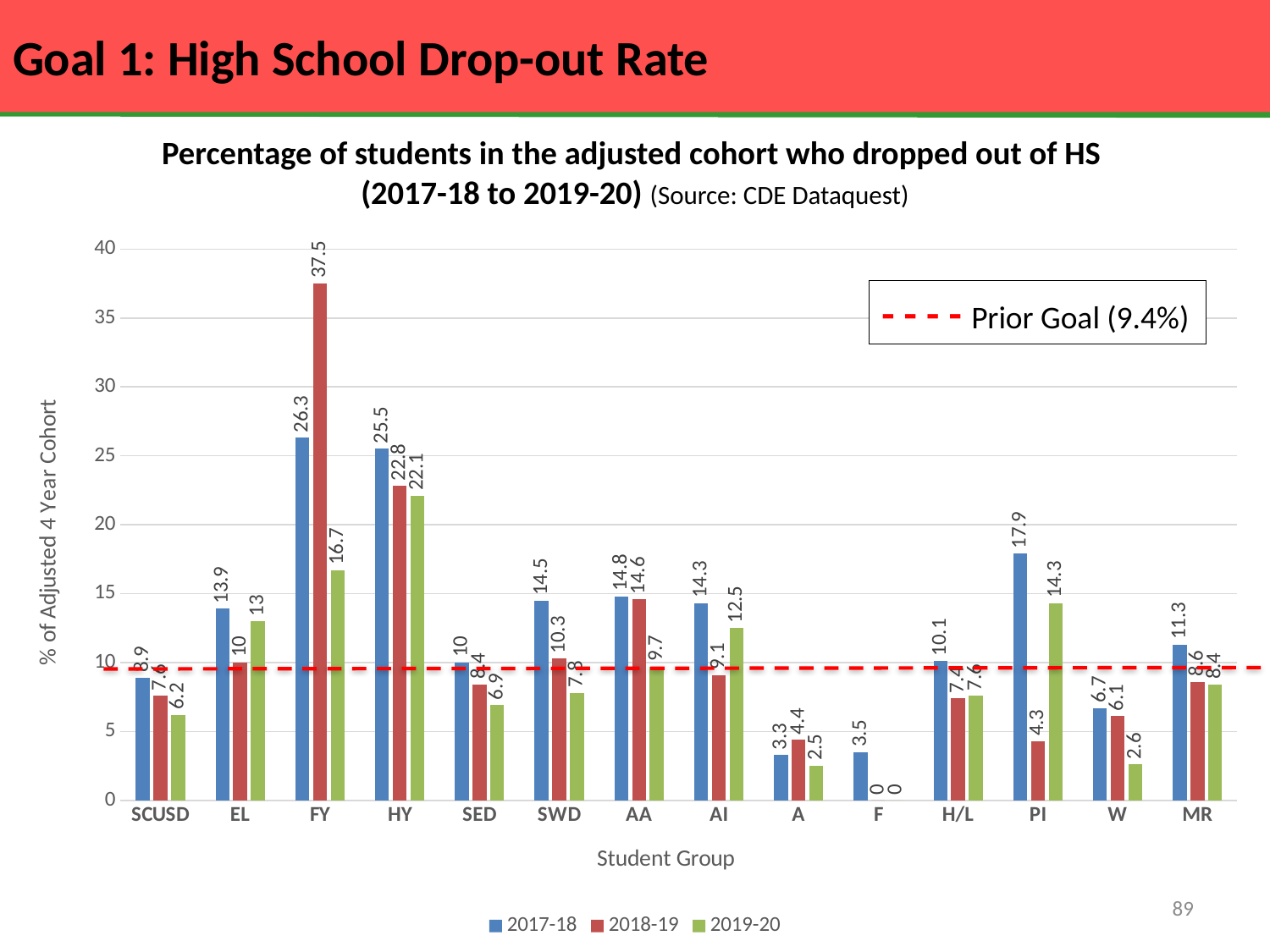
Which is larger for AI: the 2018-19 value or the 2019-20 value? 2019-20 What is the 2018-19 value for FY? 37.5 What is the difference between the 2017-18 and 2019-20 values for FY? 9.6 What is the 2019-20 value for PI? 14.3 How many series does the bottom legend list? 3 How many student groups are shown on the x axis? 14 What value does the dashed red Prior Goal line represent? 9.4% Which student group has the lowest 2017-18 value? A What is the 2017-18 value for SCUSD? 8.9 Which student group has the highest 2018-19 value? FY Do the values for W fall or rise from 2017-18 to 2019-20? fall What kind of chart is shown on the slide? bar chart